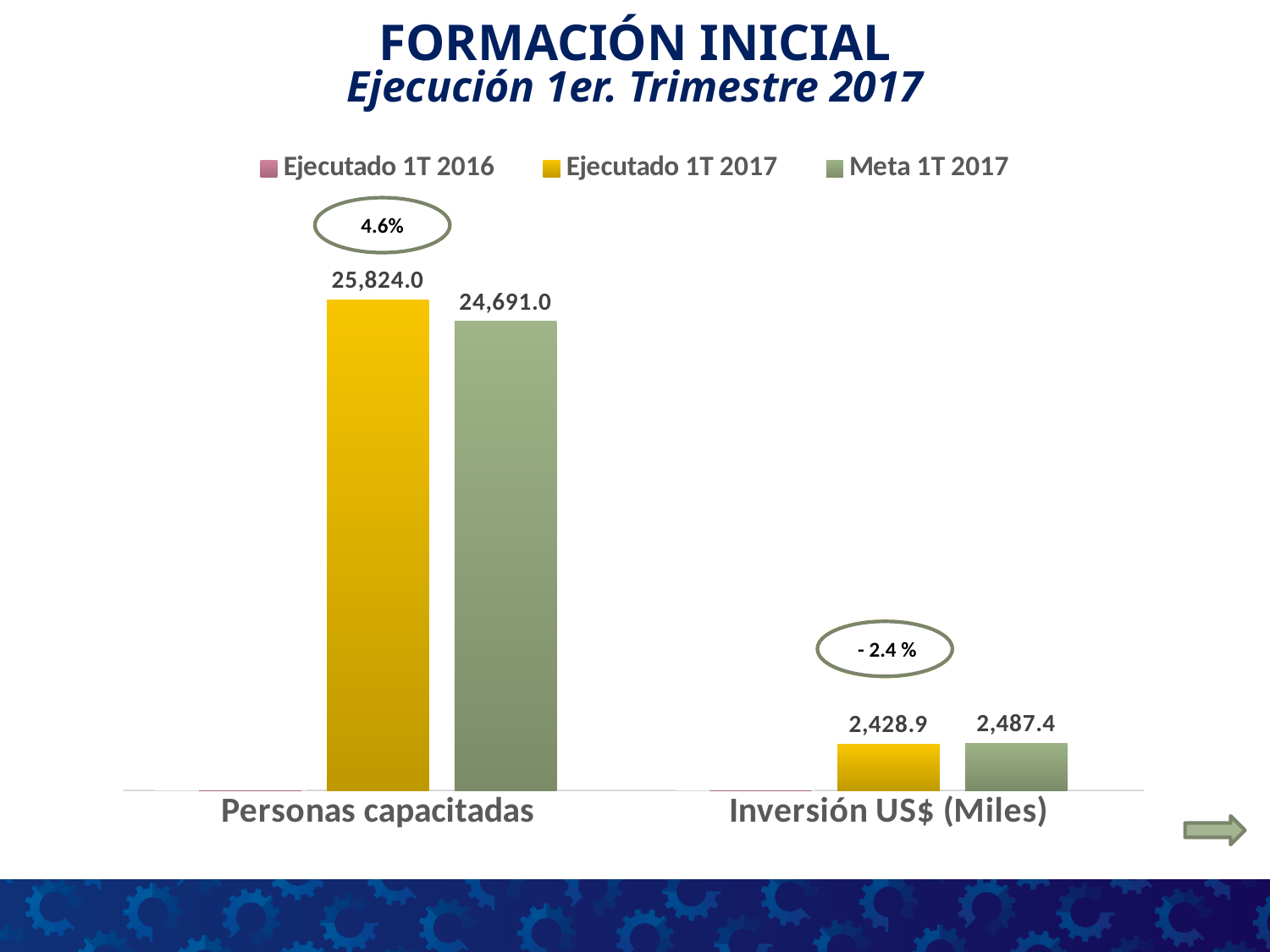
What is the Meta 1T 2017 value for Personas capacitadas? 24,691.0 For Inversión US$ (Miles), which is larger: Ejecutado 1T 2017 or Meta 1T 2017? Meta 1T 2017 What is the Ejecutado 1T 2017 value for Inversión US$ (Miles)? 2,428.9 For Personas capacitadas, which is larger: Ejecutado 1T 2017 or Meta 1T 2017? Ejecutado 1T 2017 What is the difference between the Ejecutado 1T 2017 and Meta 1T 2017 values for Personas capacitadas? 1,133.0 What is the Ejecutado 1T 2017 value for Personas capacitadas? 25,824.0 How many categories are shown on the x axis? 2 How many series does the legend list? 3 What percentage is shown in the oval above the Inversión US$ (Miles) bars? - 2.4 % What kind of chart is shown on the slide? Bar chart What is the difference between the Meta 1T 2017 and Ejecutado 1T 2017 values for Inversión US$ (Miles)? 58.5 What is the Meta 1T 2017 value for Inversión US$ (Miles)? 2,487.4